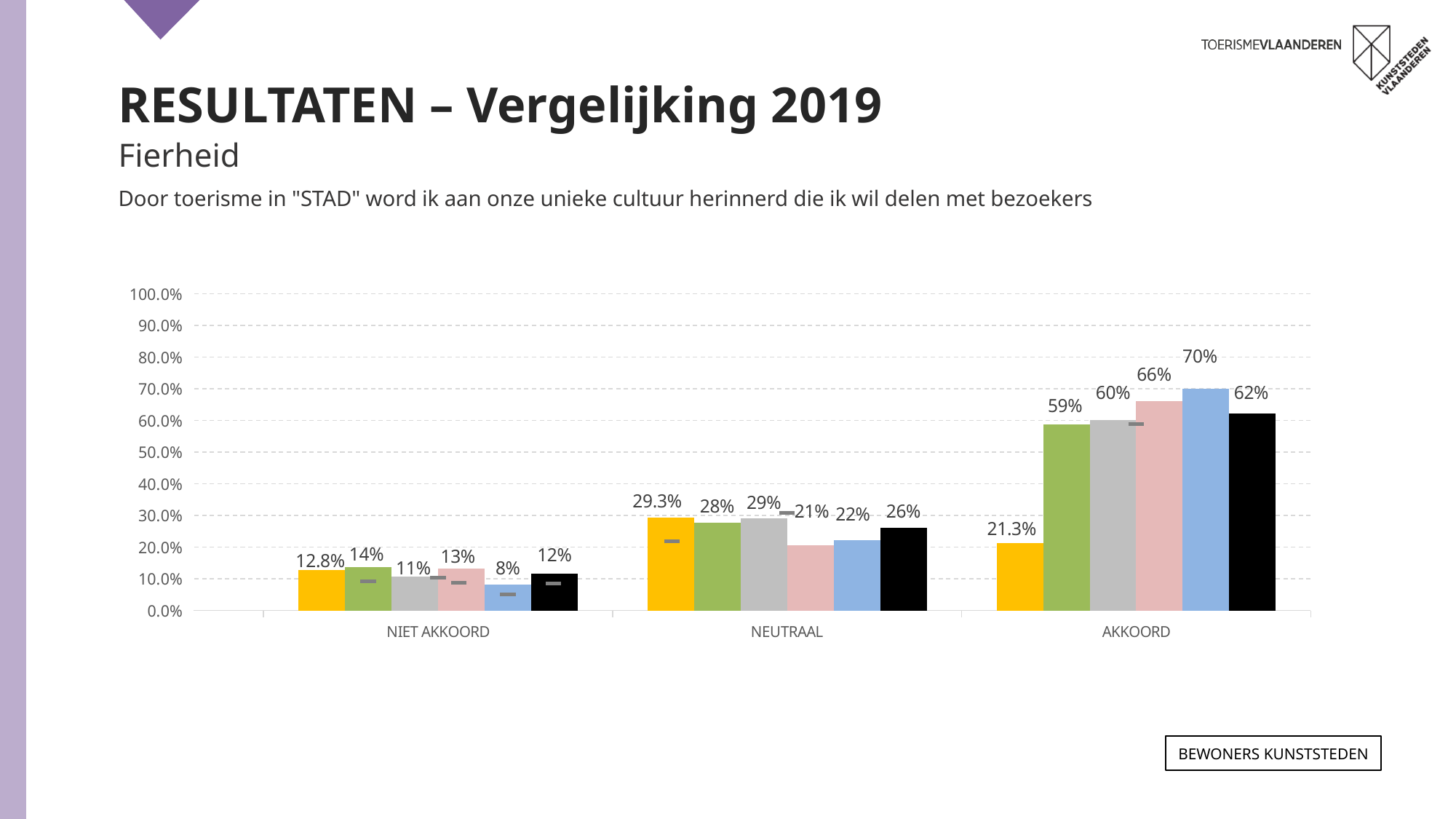
What is the value of the yellow bar in the NIET AKKOORD group? 12.8% What kind of chart is shown on the slide? bar chart What is the highest value shown in the AKKOORD group? 70% What is the value of the yellow bar in the AKKOORD group? 21.3% What is the lowest value shown in the NIET AKKOORD group? 8% What is the value of the yellow bar in the NEUTRAAL group? 29.3% How many categories are shown on the x axis of the chart? 3 How many bars are plotted in each category group? 6 In the NEUTRAAL group, which is larger: the black bar or the pink bar? the black bar What is the difference between the black bar in the AKKOORD group (62%) and the black bar in the NIET AKKOORD group (12%)? 50 percentage points Do the values of the black bars rise or fall going from NIET AKKOORD to AKKOORD along the x axis? rise Is the value of the green bar in the AKKOORD group greater or less than 50%? greater